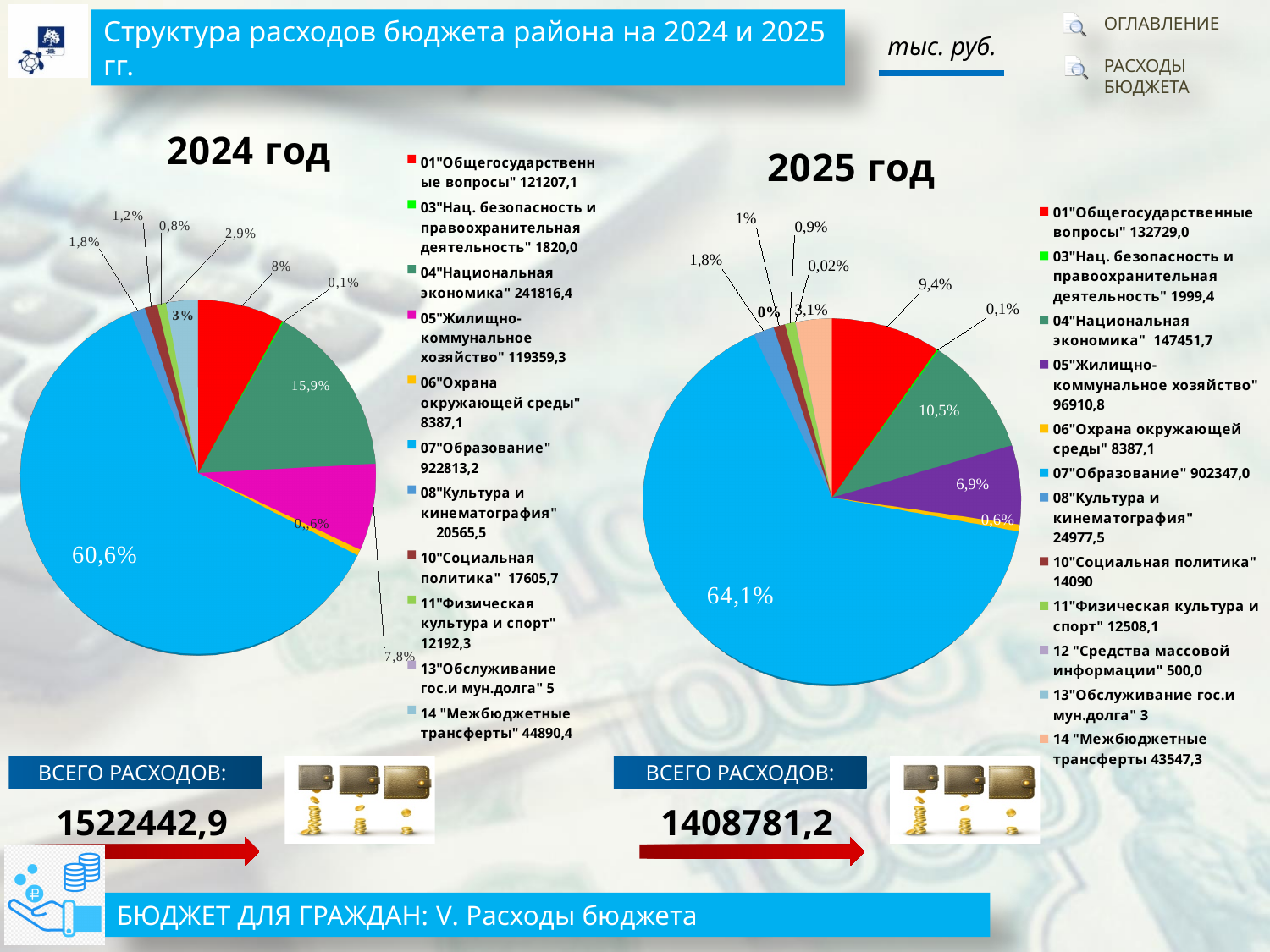
How many categories does the 2025 год legend list? 12 In the 2024 год pie chart, what share is 04"Национальная экономика"? 15,9% How many categories does the 2024 год legend list? 11 According to the 2025 год legend, what is the value for 05"Жилищно-коммунальное хозяйство"? 96910,8 In the 2025 год pie chart, what share of expenditures is 07"Образование"? 64,1% In the 2024 год pie chart, what share of expenditures is 07"Образование"? 60,6% Which year has the larger total expenditure (ВСЕГО РАСХОДОВ), 2024 or 2025? 2024 What type of chart is used for the 2024 год and 2025 год data? pie chart According to the 2024 год legend, what is the value for 01"Общегосударственные вопросы"? 121207,1 In the 2024 год chart, which category has the largest slice? 07"Образование" What is the difference between the total expenditures for 2024 (1522442,9) and 2025 (1408781,2)? 113661,7